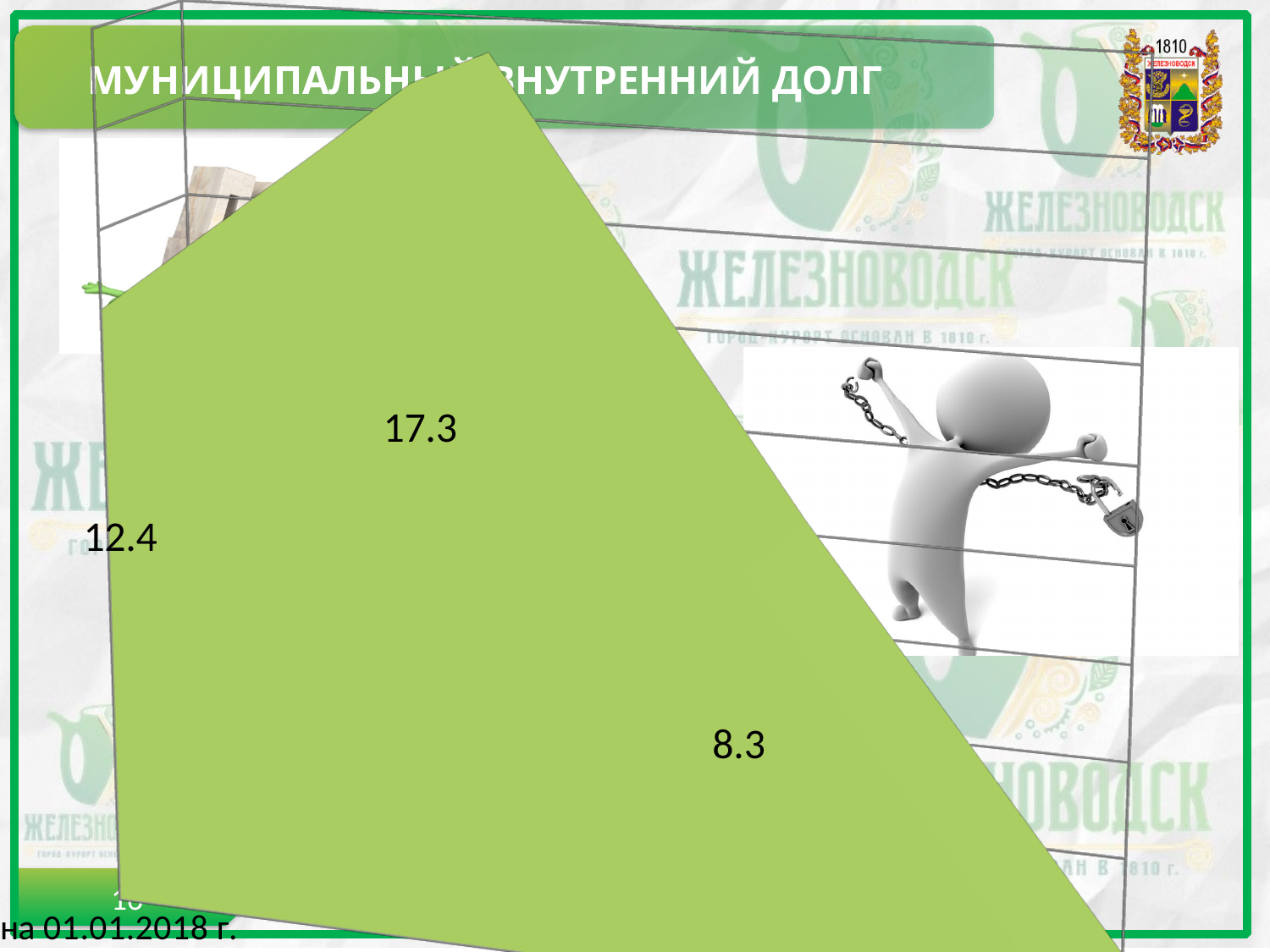
What is the difference between the second value (17.3) and the first value (12.4)? 4.9 Do the values rise or fall from the second point to the third point? fall Which is larger, the first value (12.4) or the third value (8.3)? 12.4 What is the difference between the highest value (17.3) and the lowest value (8.3)? 9.0 What is the highest value labelled on the chart? 17.3 Do the values rise or fall from the first point to the second point? rise What is the title of the chart on the slide? МУНИЦИПАЛЬНЫЙ ВНУТРЕННИЙ ДОЛГ What is the value labelled for the first point, на 01.01.2018 г.? 12.4 Which position along the chart has the highest value: the first, second or third point? second How many data points are labelled on the chart? 3 What kind of chart is shown on the slide? area chart What is the lowest value labelled on the chart? 8.3